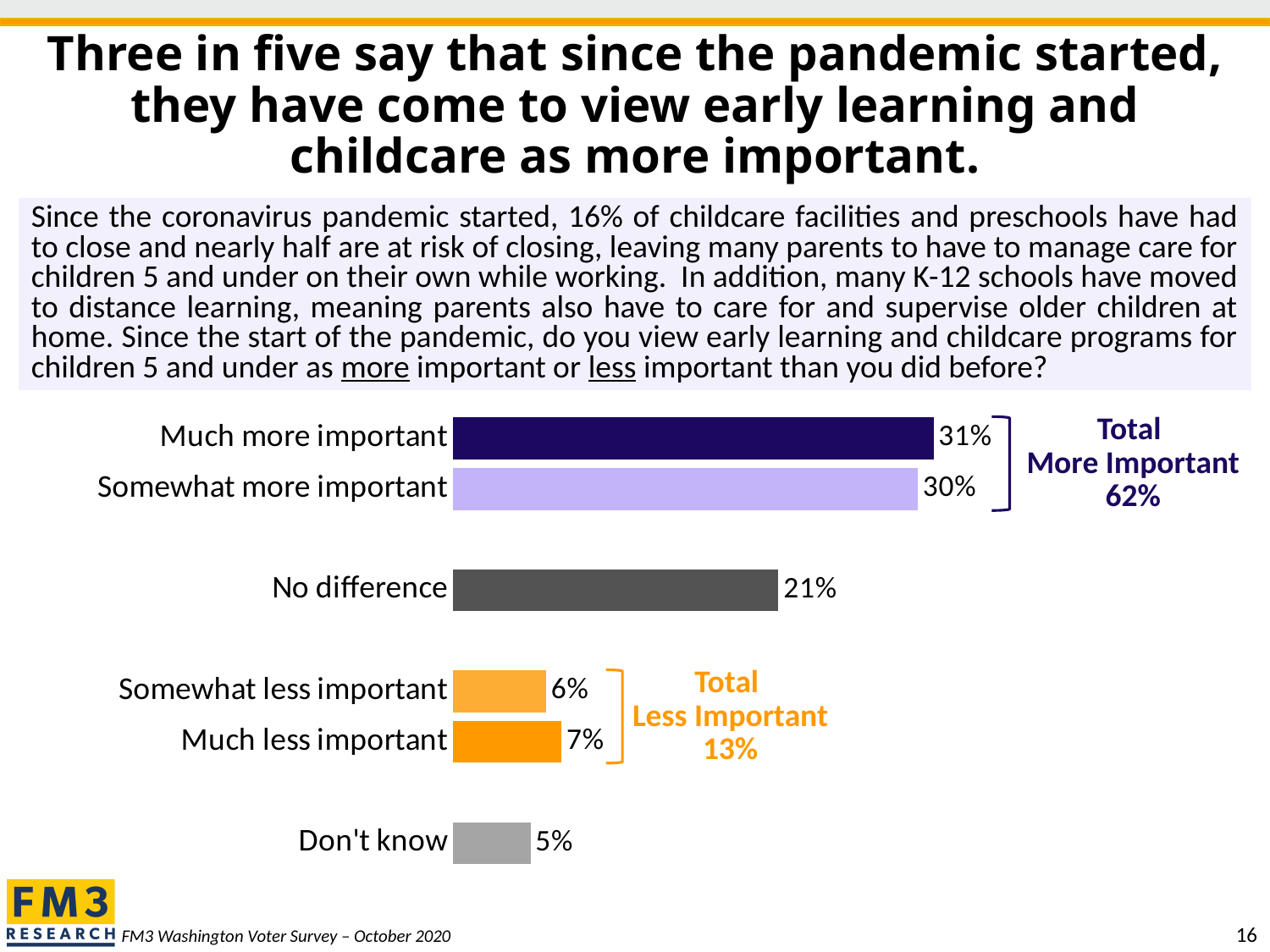
What percentage of respondents said 'Much less important'? 7% What is the difference between the 'No difference' and 'Somewhat less important' percentages? 15 percentage points What is the 'Total More Important' percentage shown on the chart? 62% Which is larger, the percentage for 'Much less important' or 'Somewhat less important'? Much less important What type of chart is shown on the slide? Bar chart What percentage of respondents answered 'Don't know'? 5% What percentage of respondents said early learning and childcare is much more important? 31% What percentage of respondents said 'Somewhat more important'? 30% Which response category has the lowest percentage? Don't know How many response categories are shown in the chart? 6 What percentage of respondents said 'No difference'? 21% Which response category has the highest percentage? Much more important